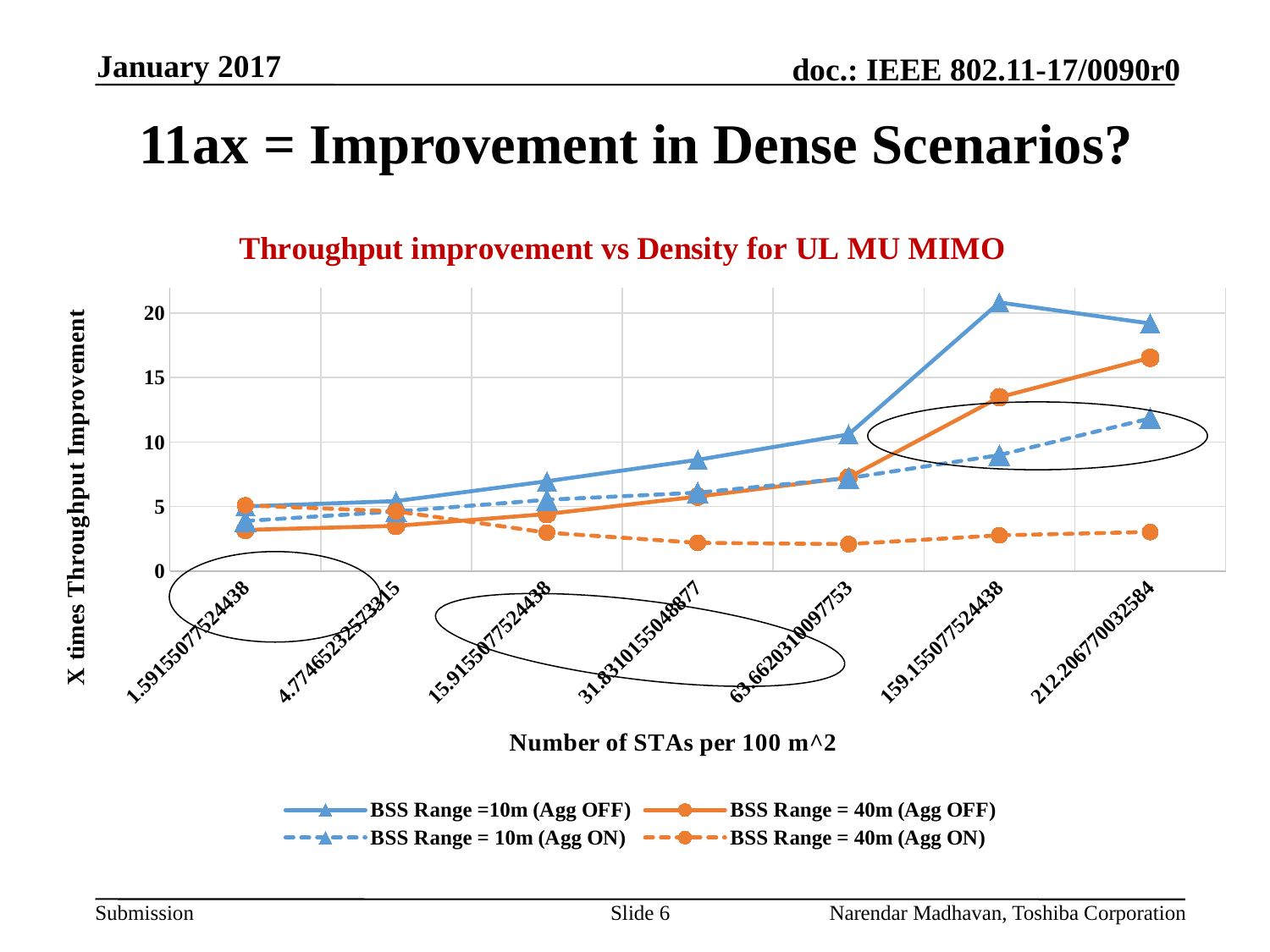
At 212.206770032584, which is higher: BSS Range =10m (Agg OFF) or BSS Range = 40m (Agg OFF)? BSS Range =10m (Agg OFF) Which series has the lowest value at 159.155077524438? BSS Range = 40m (Agg ON) How many categories are shown on the x axis? 7 At which x-axis category does BSS Range =10m (Agg OFF) reach its highest value? 159.155077524438 Is the value for BSS Range = 40m (Agg OFF) at 212.206770032584 greater or less than 15? greater How many series does the legend list? 4 What is the title of the chart? Throughput improvement vs Density for UL MU MIMO Is the value for BSS Range = 40m (Agg ON) at 63.6620310097753 greater or less than 5? less Is the value for BSS Range = 10m (Agg ON) at 212.206770032584 greater or less than 10? greater What is the label of the x axis? Number of STAs per 100 m^2 What kind of chart is shown on the slide? line chart